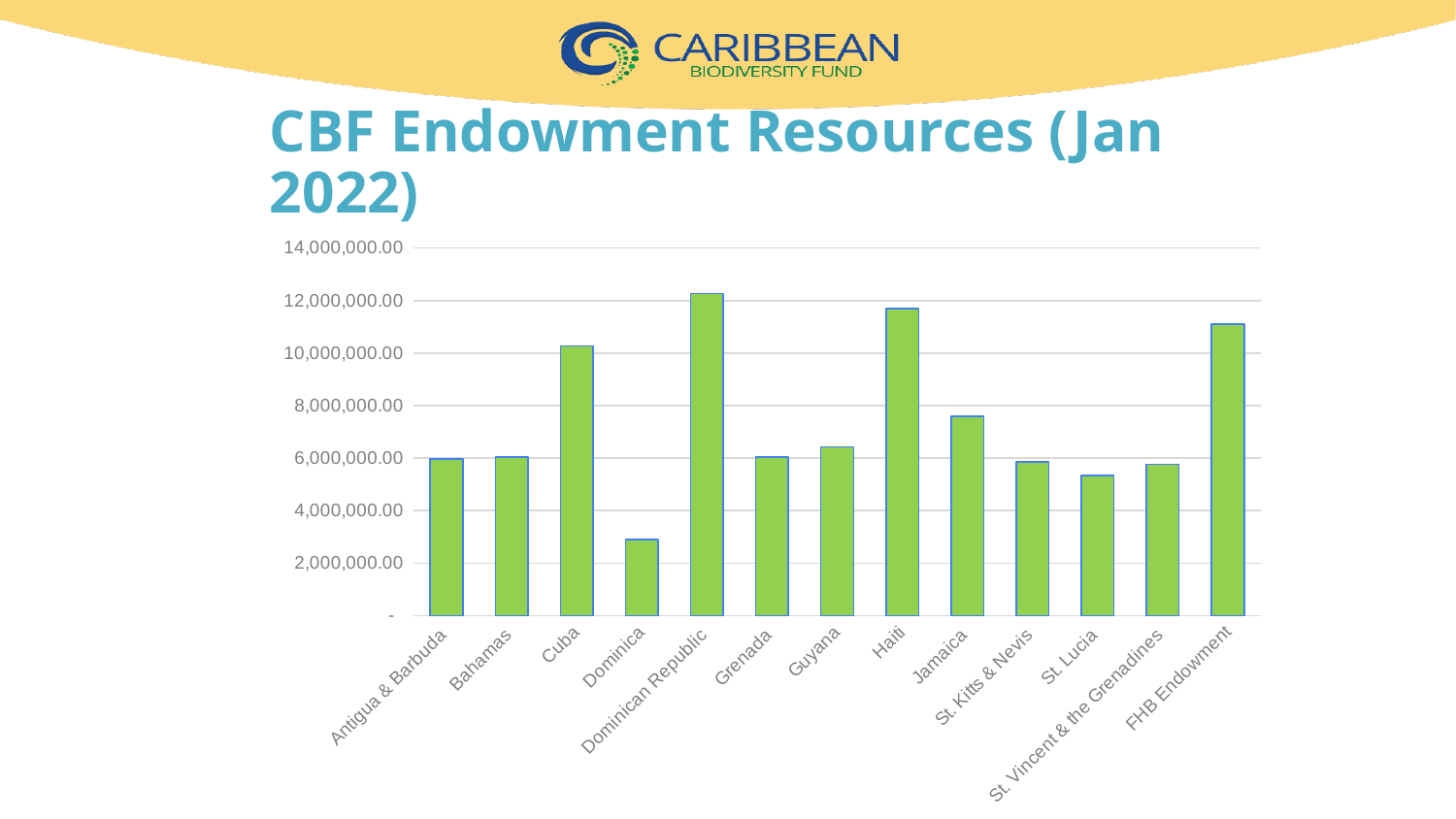
Which is larger, the value for Cuba or the value for Jamaica? Cuba Is the value for Jamaica greater or less than 8,000,000.00? less Is the value for Cuba greater or less than 10,000,000.00? greater Is the value for St. Lucia greater or less than 6,000,000.00? less Which category has the lowest value on the chart? Dominica How many categories are plotted on the chart? 13 What kind of chart is shown on the slide? Bar chart Which category has the highest value on the chart? Dominican Republic Which is larger, the value for Dominica or the value for St. Lucia? St. Lucia What is the title of the slide containing the chart? CBF Endowment Resources (Jan 2022)